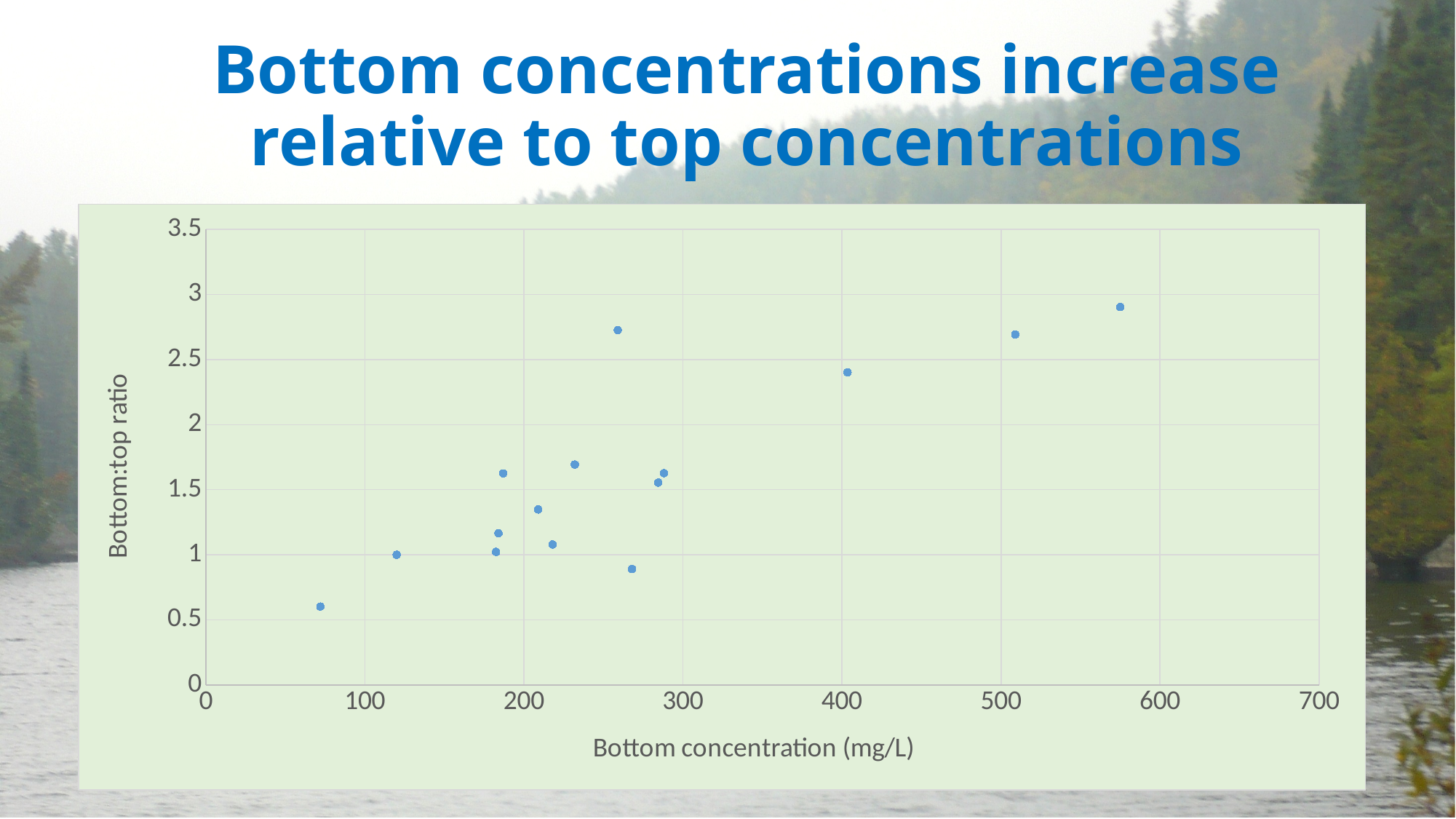
What is the maximum value shown on the y axis? 3.5 How many data points are plotted on the chart? 15 Is the bottom:top ratio for the point near 400 mg/L greater or less than 2? greater Is the bottom:top ratio for the rightmost point (near 575 mg/L) greater or less than 2.5? greater Is the bottom:top ratio for the point near 270 mg/L greater or less than 1? less Which point has a higher bottom:top ratio: the one near 400 mg/L or the one near 575 mg/L? The one near 575 mg/L Which point has the lowest bottom:top ratio: the one near 70 mg/L or the one near 120 mg/L? The one near 70 mg/L What is the label of the y axis? Bottom:top ratio What kind of chart is shown on the slide? Scatter plot What is the label of the x axis? Bottom concentration (mg/L) Overall, does the bottom:top ratio rise or fall as bottom concentration increases along the x axis? Rises